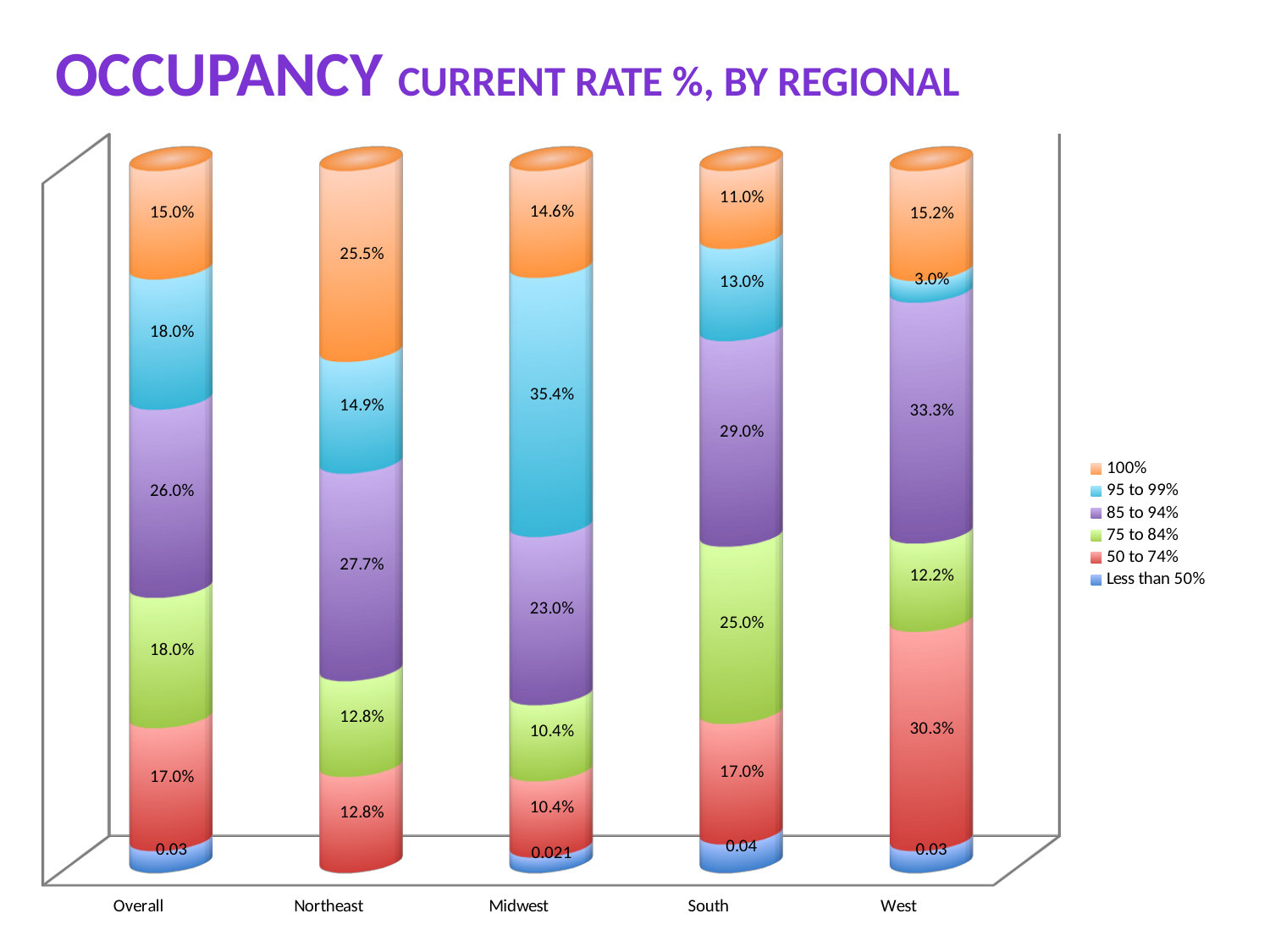
How many series does the legend list? 6 Which region has the highest value in the 85 to 94% series? West How many regional categories are shown on the x axis? 5 What is the value of the 50 to 74% segment for West? 30.3% What is the value of the 100% segment for Northeast? 25.5% What kind of chart is shown on the slide? Stacked bar chart Which is larger: the 75 to 84% segment for South or the 75 to 84% segment for Midwest? South What is the value of the 85 to 94% segment for South? 29.0% What is the difference between the 100% segment for Northeast and the 100% segment for Overall? 10.5 percentage points Which region has the highest value in the 100% series? Northeast What is the value of the 95 to 99% segment for Midwest? 35.4% Which region has the lowest value in the 95 to 99% series? West